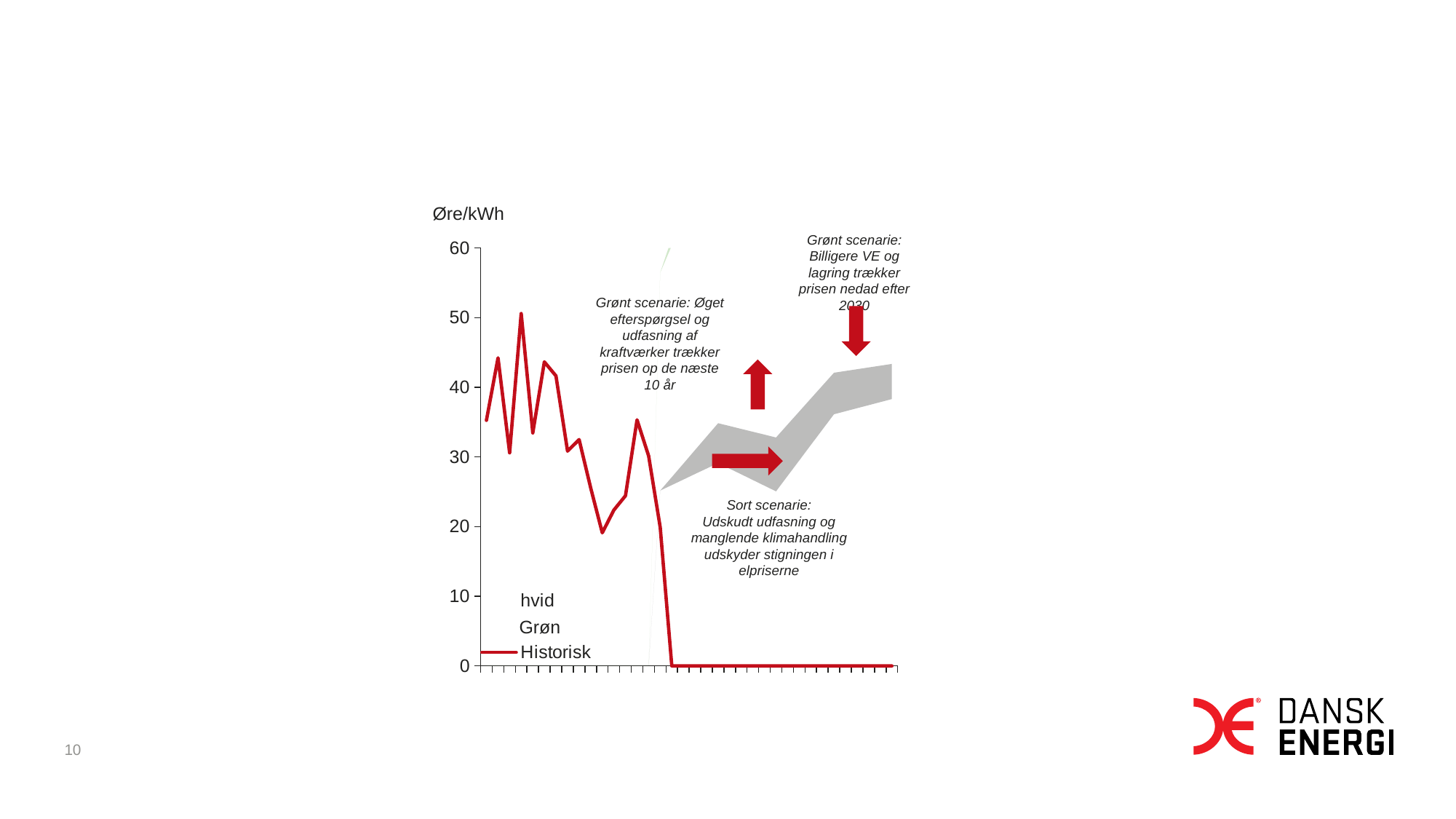
What is the highest value shown on the y axis? 60 What unit is shown on the y axis of the chart? Øre/kWh How many series does the legend list? 3 Which legend entry is drawn as a red line? Historisk Is the peak value of the Historisk line greater or less than 40? greater Is the peak value of the Historisk line greater or less than 60? less Does the Historisk line end higher or lower than it starts? lower What kind of chart is shown on the slide? line chart